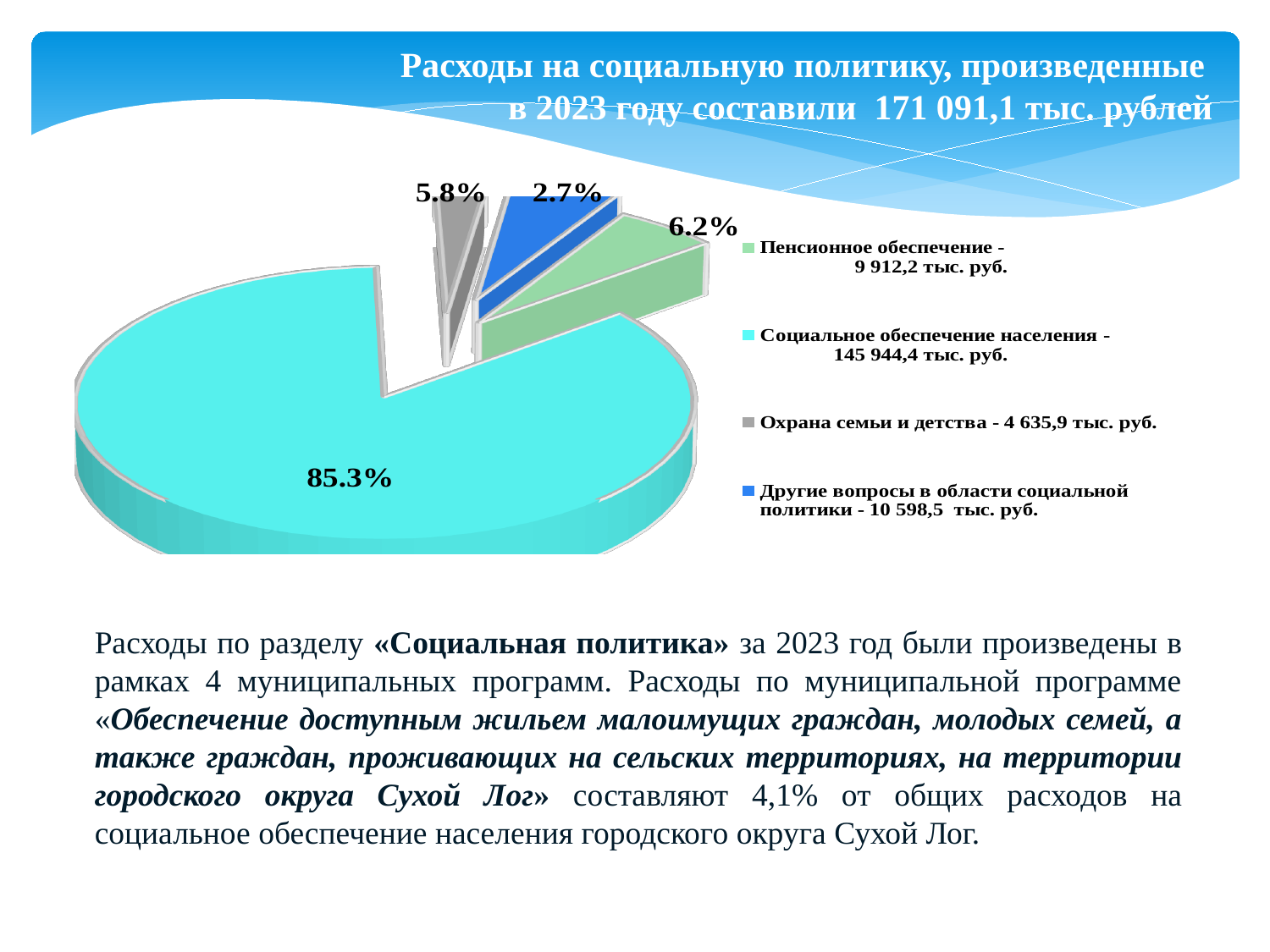
According to the legend, what is the value for Охрана семьи и детства? 4 635,9 тыс. руб. How many categories does the legend of the pie chart list? 4 What kind of chart is shown on the slide? pie chart According to the legend, what is the value for Другие вопросы в области социальной политики? 10 598,5 тыс. руб. Which is larger: Пенсионное обеспечение or Другие вопросы в области социальной политики? Другие вопросы в области социальной политики Which category has the largest share of the pie? Социальное обеспечение населения What share of the pie does the largest slice represent? 85.3% According to the slide title, what was the total spending on social policy in 2023? 171 091,1 тыс. рублей What is the difference between Социальное обеспечение населения and Пенсионное обеспечение in тыс. руб.? 136 032,2 According to the legend, what is the value for Социальное обеспечение населения? 145 944,4 тыс. руб. Which category has the smallest value in the legend? Охрана семьи и детства According to the legend, what is the value for Пенсионное обеспечение? 9 912,2 тыс. руб.